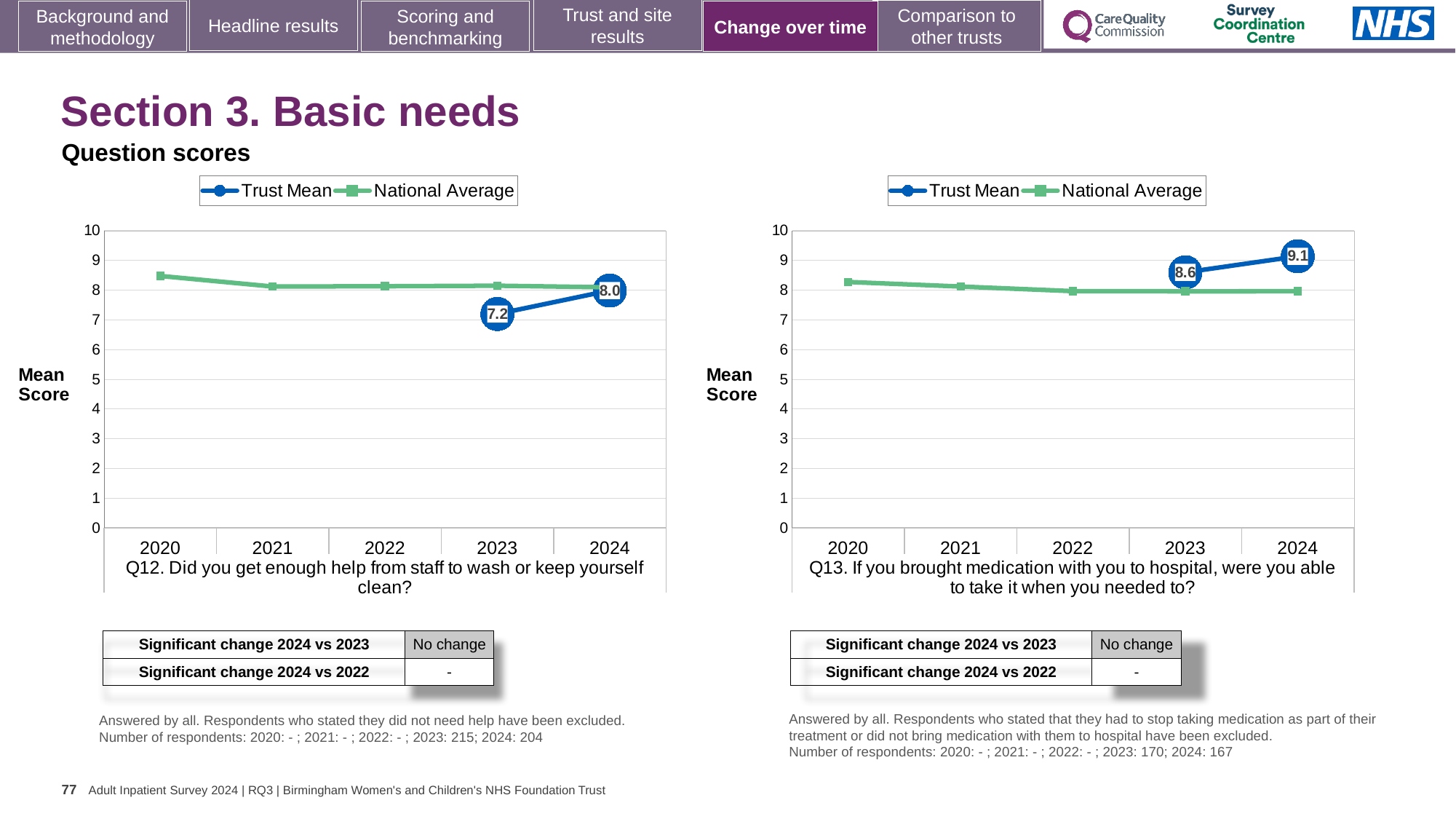
In the Q13 chart (right), what is the Trust Mean value for 2024? 9.1 In the Q12 chart (left), what is the Trust Mean value for 2024? 8.0 In the Q13 chart (right), what is the difference between the Trust Mean in 2024 and in 2023? 0.5 In the Q13 chart (right), does the Trust Mean rise or fall from 2023 to 2024? rise How many years are shown on the x axis of the Q13 chart (right)? 5 How many series does the legend of the Q12 chart (left) list? 2 In the Q12 chart (left), is the National Average for 2020 greater or less than 8? greater In the Q13 chart (right), is the Trust Mean for 2024 greater or less than the National Average for 2024? greater In the Q12 chart (left), by how much did the Trust Mean change from 2023 to 2024? 0.8 What kind of chart is the Q12 chart (left)? line chart In the Q12 chart (left), what is the Trust Mean value for 2023? 7.2 In the Q13 chart (right), what is the Trust Mean value for 2023? 8.6